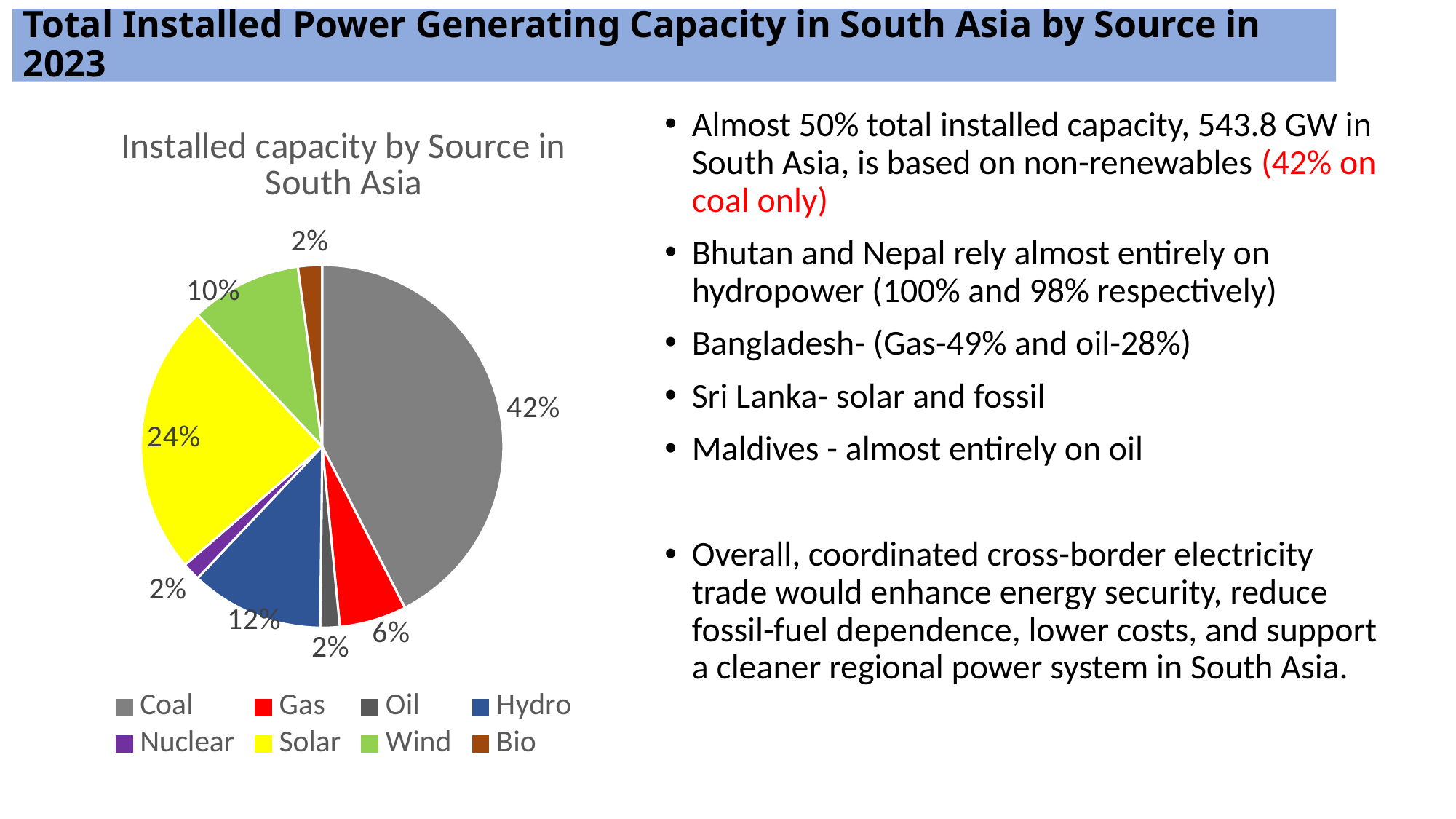
What share of installed capacity does Gas account for? 6% What share of installed capacity does Hydro account for? 12% How many sources are listed in the chart legend? 8 What is the difference in percentage points between the Coal share and the Solar share? 18 percentage points What share of installed capacity does Solar account for? 24% What colour represents Solar in the pie chart? Yellow What share of installed capacity does Coal account for? 42% What is the title of the chart? Installed capacity by Source in South Asia Which source has the largest share of installed capacity? Coal What type of chart is shown on the slide? Pie chart Which has a larger share, Solar or Hydro? Solar What share of installed capacity does Wind account for? 10%